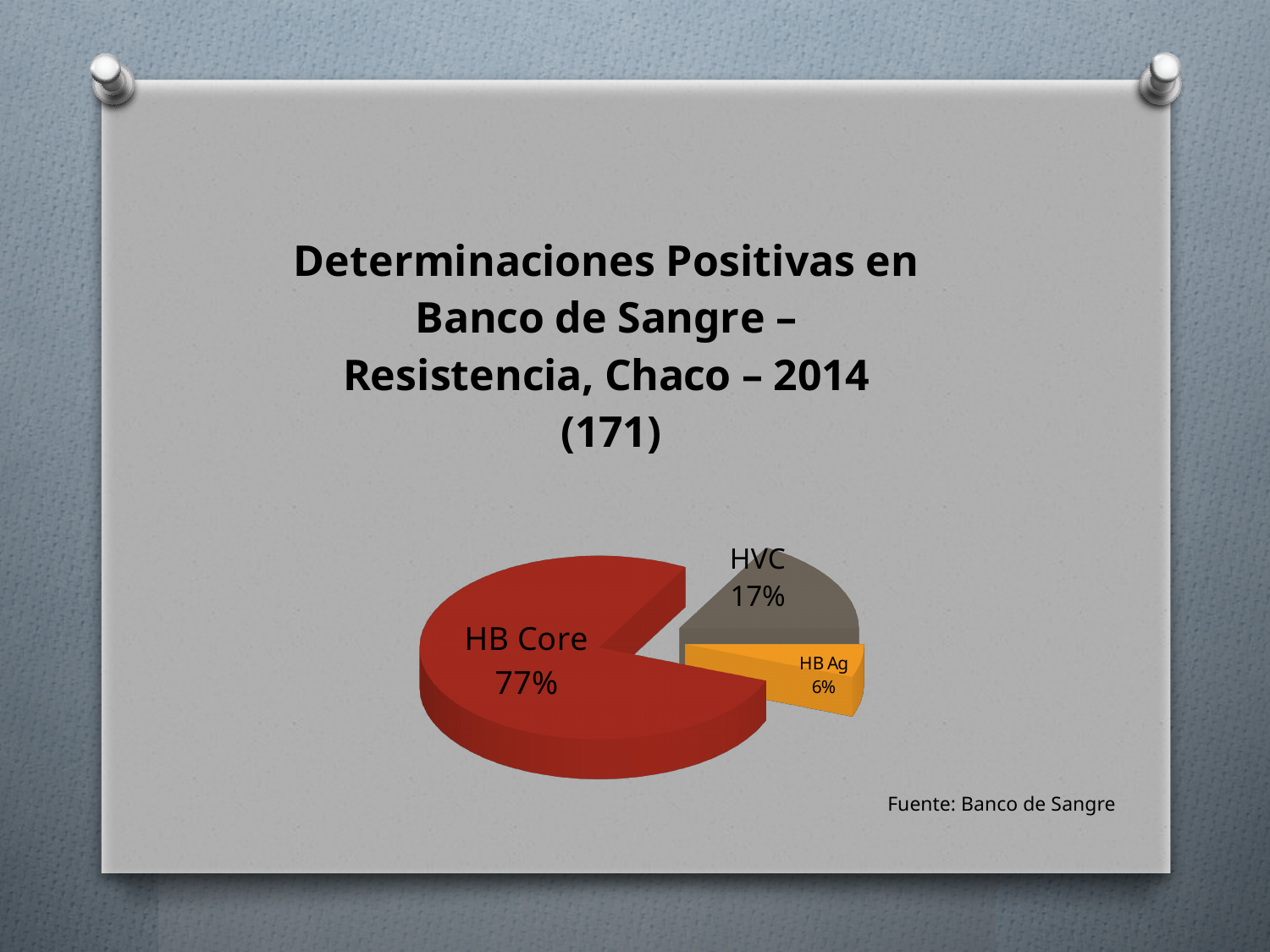
What is the difference in percentage points between the HVC and HB Ag slices? 11 What source is cited below the chart? Fuente: Banco de Sangre What is the difference in percentage points between the HB Core and HVC slices? 60 What colour is the HB Core slice? red Which category has the largest slice of the pie? HB Core How many slices does the pie chart have? 3 What share of the pie does HB Core represent? 77% What type of chart is shown on the slide? pie chart Which slice is larger, HVC or HB Ag? HVC What share of the pie does HVC represent? 17% What share of the pie does HB Ag represent? 6% Which category has the smallest slice of the pie? HB Ag